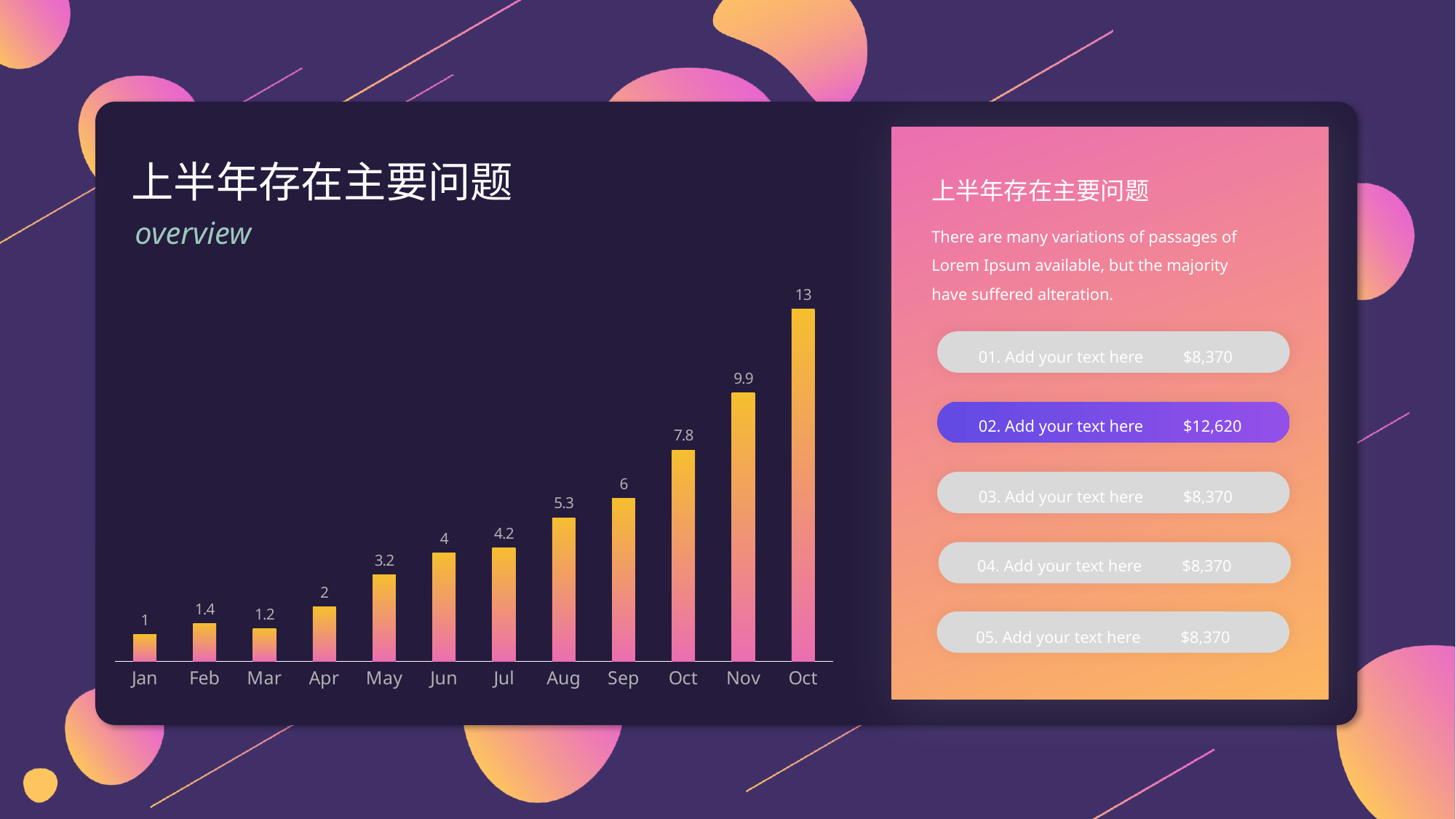
Which month has the lowest value in the bar chart? Jan What is the value for Jan in the bar chart? 1 Do the values generally rise or fall from left to right along the x axis? rise What is the difference between the values for Sep and Aug? 0.7 What is the value for Aug in the bar chart? 5.3 What is the difference between the values for Nov and Jul? 5.7 Which has a larger value, Feb or Mar? Feb What kind of chart is shown on the slide? bar chart What is the value for Nov in the bar chart? 9.9 What is the highest value shown in the bar chart? 13 What is the value for May in the bar chart? 3.2 How many bars are shown in the chart? 12